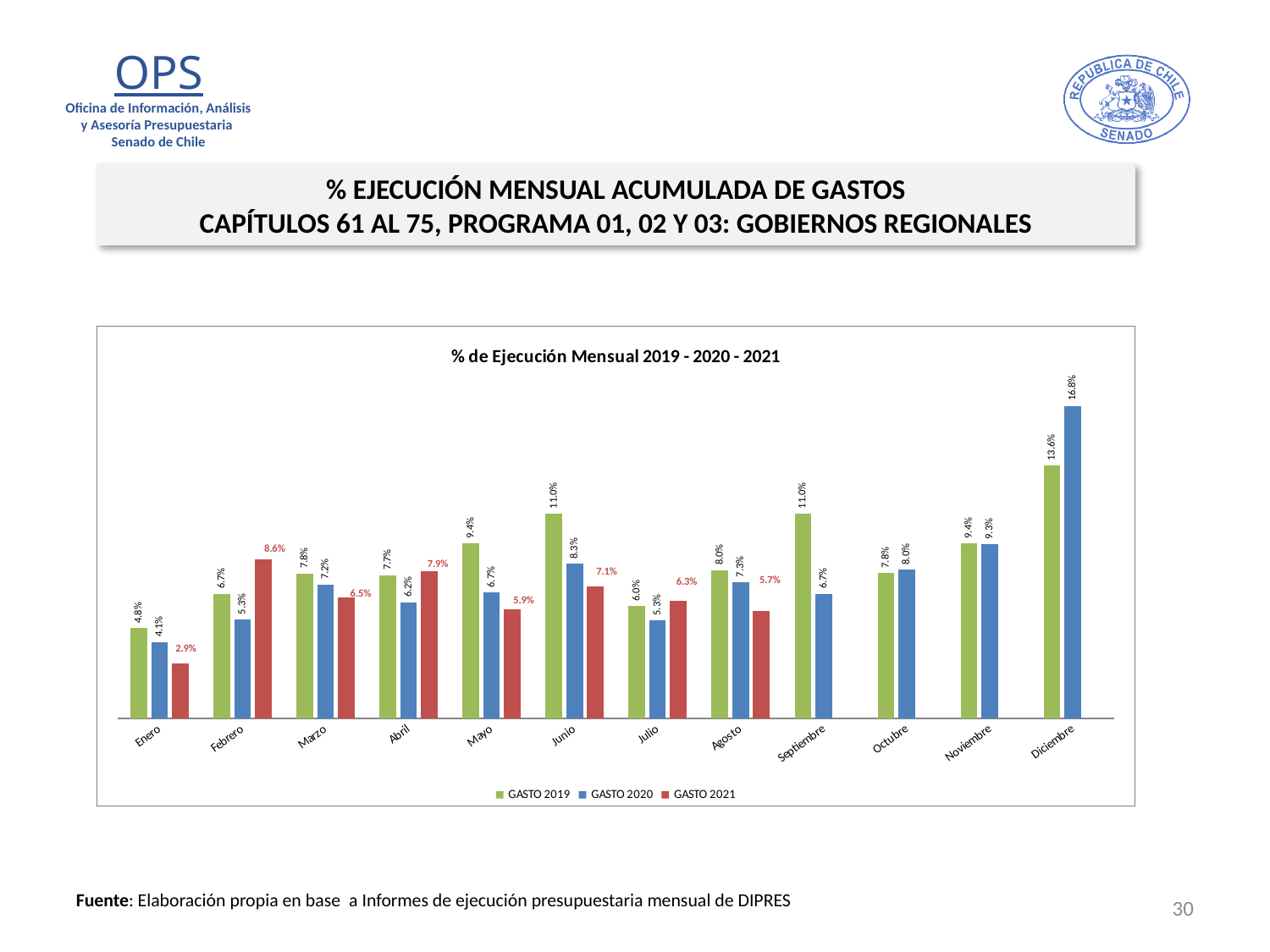
What is the GASTO 2020 value for Diciembre? 16.8% What is the difference between the GASTO 2020 and GASTO 2019 values for Diciembre? 3.2% How many months are shown on the x axis? 12 What is the title of the chart? % de Ejecución Mensual 2019 - 2020 - 2021 Which month has the lowest GASTO 2019 value? Enero Which series is shown in red? GASTO 2021 Which is larger for Abril: GASTO 2019 or GASTO 2021? GASTO 2021 What is the GASTO 2019 value for Mayo? 9.4% How many series does the legend list? 3 What kind of chart is shown? Bar chart What is the GASTO 2021 value for Febrero? 8.6% Which month has the highest GASTO 2021 value? Febrero